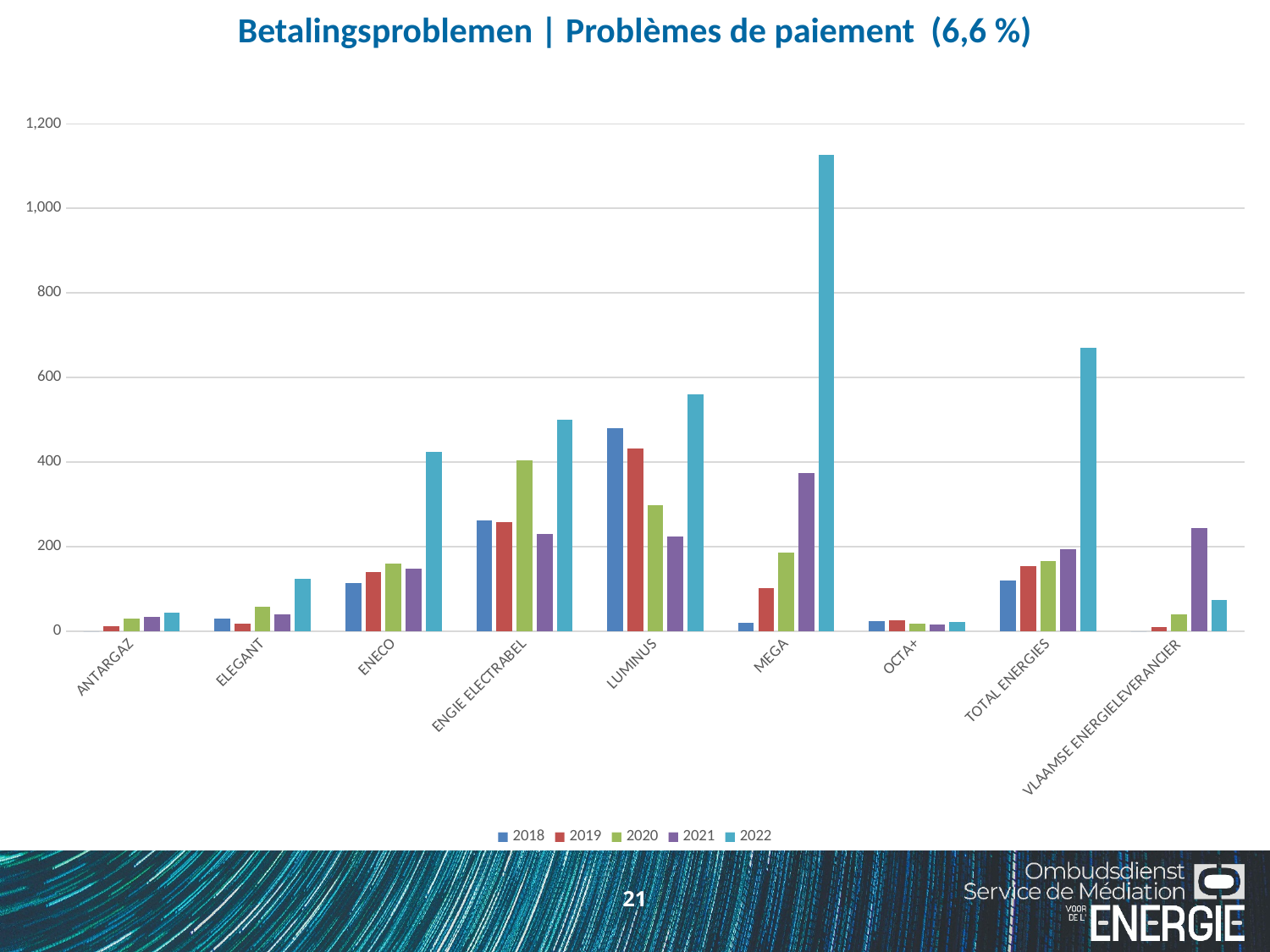
Which is larger, the 2018 value for LUMINUS or the 2018 value for ENGIE ELECTRABEL? LUMINUS For LUMINUS, which year has the lowest value? 2021 Which is larger, the 2021 value for MEGA or the 2021 value for ENECO? MEGA Which supplier has the highest bar in the chart? MEGA Is the 2022 value for MEGA greater or less than 1,000? greater What percentage is shown in the chart title? 6,6 % What kind of chart is shown on the slide? bar chart How many supplier categories are shown on the x axis? 9 Is the 2018 value for LUMINUS greater or less than 400? greater Is the 2022 value for OCTA+ greater or less than 200? less How many series does the legend list? 5